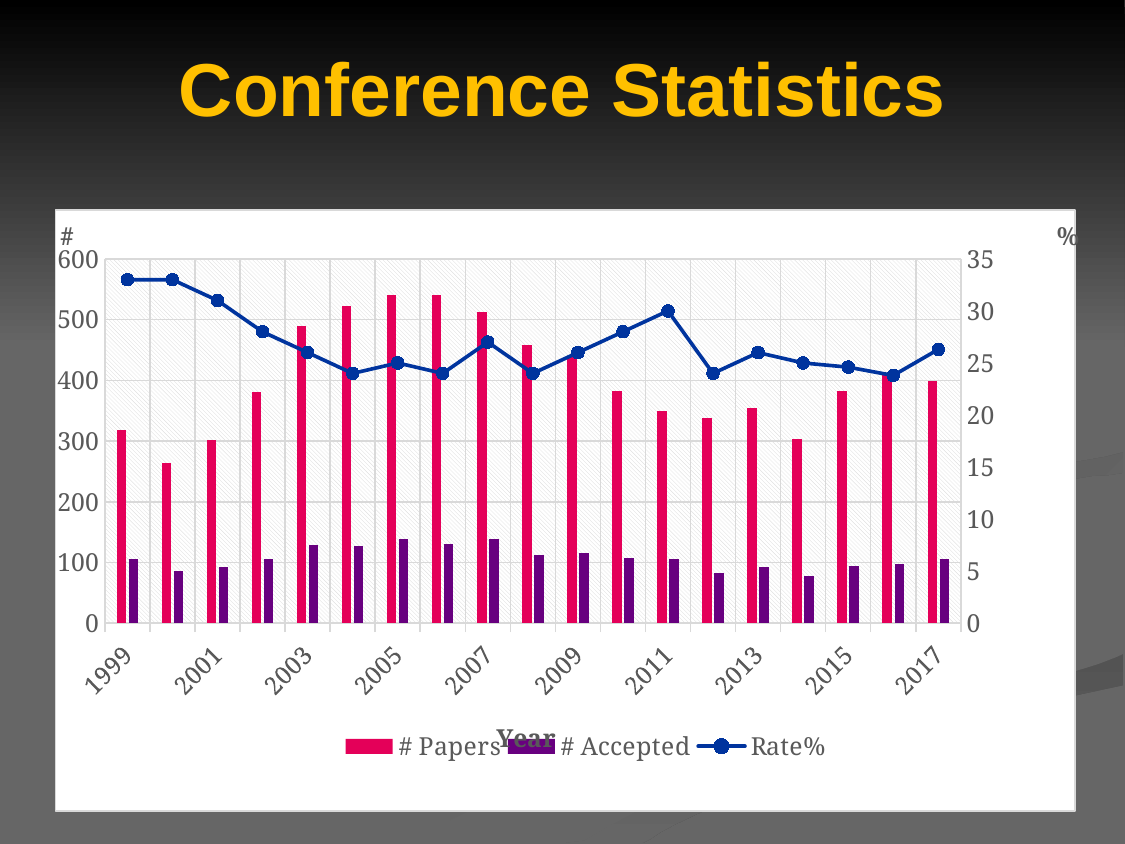
How many years are shown on the x axis? 19 How many series does the legend list? 3 Is the value for # Papers in 2000 greater or less than 300? less Is the value for # Accepted in 2007 greater or less than 100? greater Is the value for # Papers in 2005 greater or less than 500? greater What is the label of the x axis? Year What kind of chart is this? A bar chart combined with a line chart Does the Rate% line rise or fall from 1999 to 2004? fall Which year has the lowest value for # Papers? 2000 Which is larger, the # Papers value in 2005 or in 2014? 2005